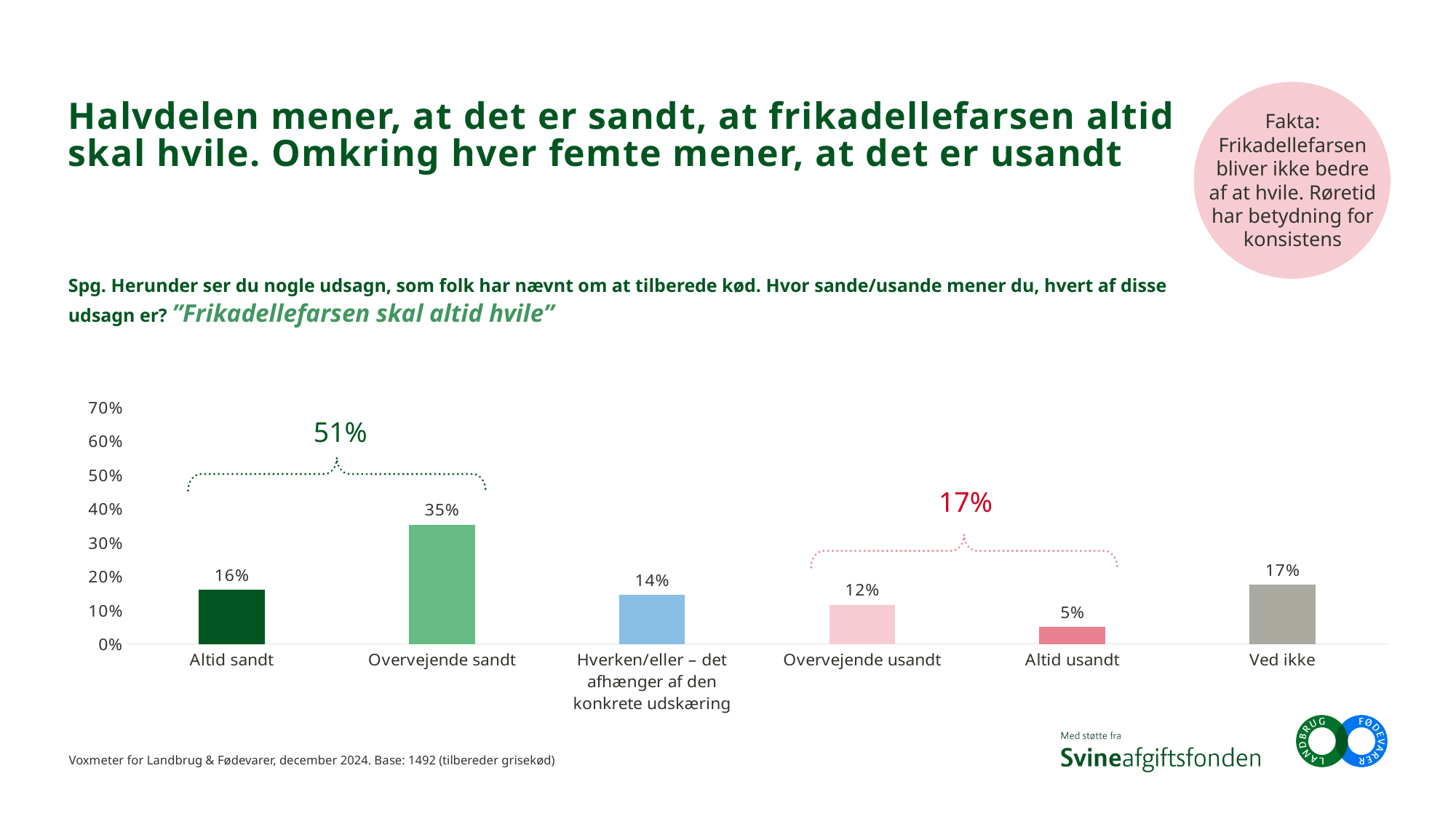
Which category has the lowest value in the chart? Altid usandt What kind of chart is shown on the slide? Bar chart Which is larger, the value for "Overvejende usandt" or the value for "Hverken/eller – det afhænger af den konkrete udskæring"? Hverken/eller – det afhænger af den konkrete udskæring What combined percentage is shown by the bracket above "Overvejende usandt" and "Altid usandt"? 17% What percentage of respondents answered "Overvejende sandt"? 35% What percentage answered "Ved ikke"? 17% What is the value shown for "Altid usandt"? 5% What is the difference between the values for "Overvejende sandt" and "Altid sandt"? 19% How many categories are shown on the x axis of the chart? 6 Is the value for "Overvejende sandt" greater or less than 30%? greater What combined percentage is shown by the bracket above "Altid sandt" and "Overvejende sandt"? 51% Which category has the highest value in the chart? Overvejende sandt